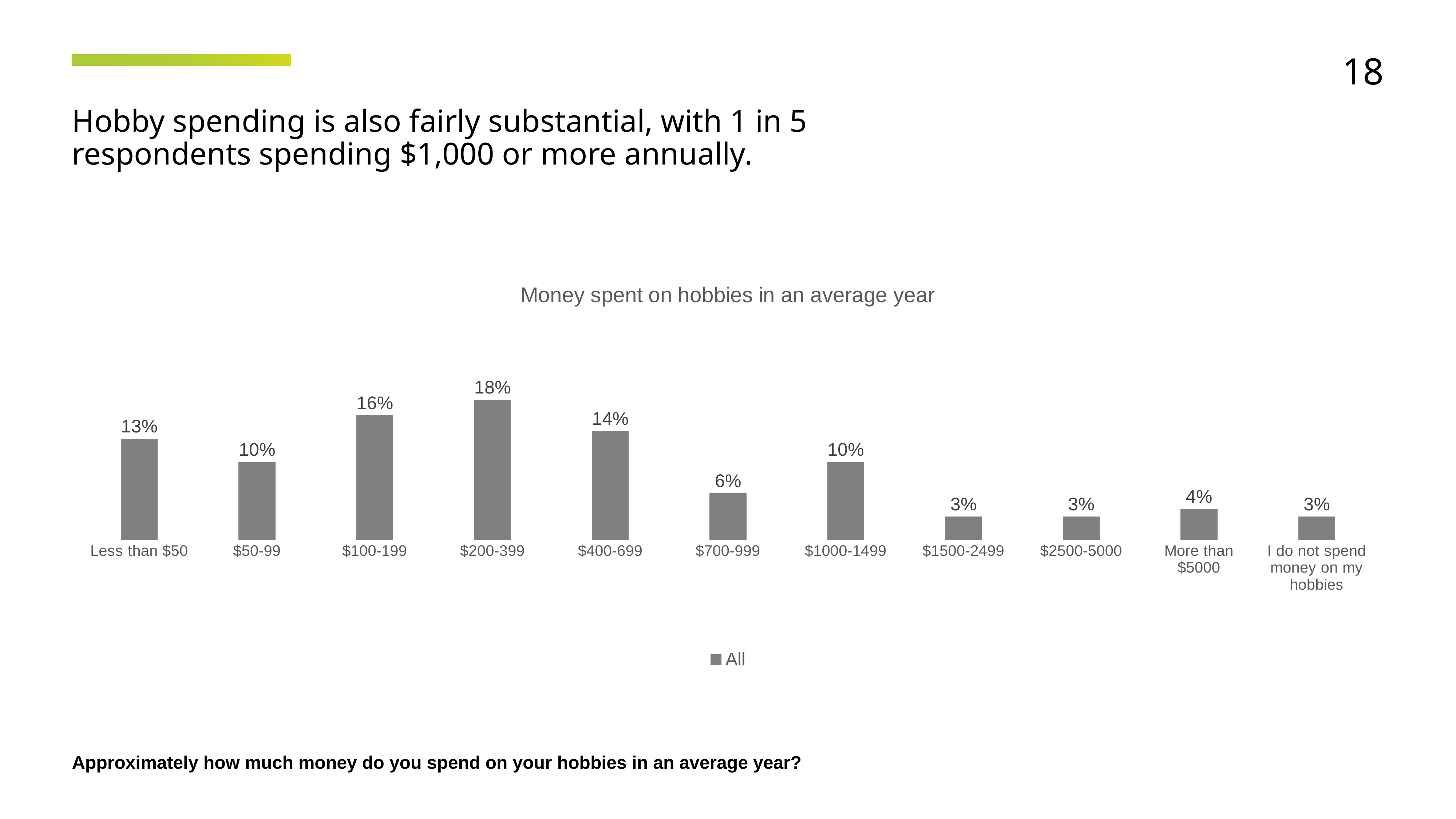
What percentage of respondents spend $200-399 on hobbies in an average year? 18% What percentage of respondents do not spend money on their hobbies? 3% What is the total of the values for $1000-1499 and $1500-2499? 13% How many series does the legend list? 1 How many categories are shown on the x axis of the chart? 11 What is the title of the chart? Money spent on hobbies in an average year What kind of chart is shown on the slide? Bar chart Which is larger, the value for $400-699 or the value for $1000-1499? $400-699 What is the value for the 'Less than $50' category? 13% Which spending category has the highest percentage of respondents? $200-399 What is the name of the series listed in the legend? All What is the difference between the values for $100-199 and $700-999? 10%